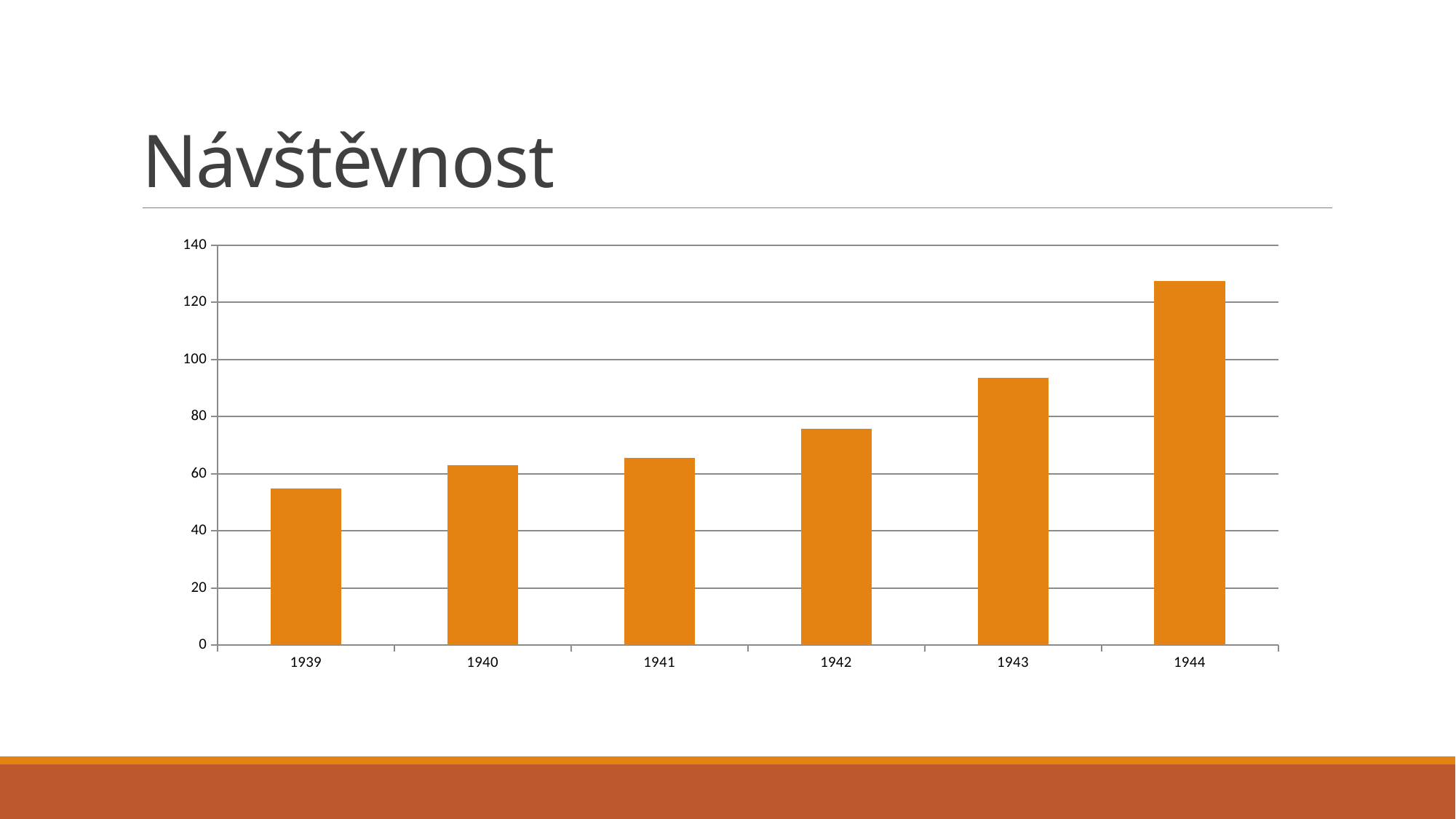
Is the value for 1939 greater or less than 60? less How many years are shown on the x axis of the chart? 6 Do the values generally rise or fall from 1939 to 1944? rise Which is larger, the value for 1943 or the value for 1942? 1943 Is the value for 1943 greater or less than 100? less What is the title of the slide containing the chart? Návštěvnost Which year has the highest value in the chart? 1944 Is the value for 1944 greater or less than 120? greater What kind of chart is shown on the slide? bar chart Which year has the lowest value in the chart? 1939